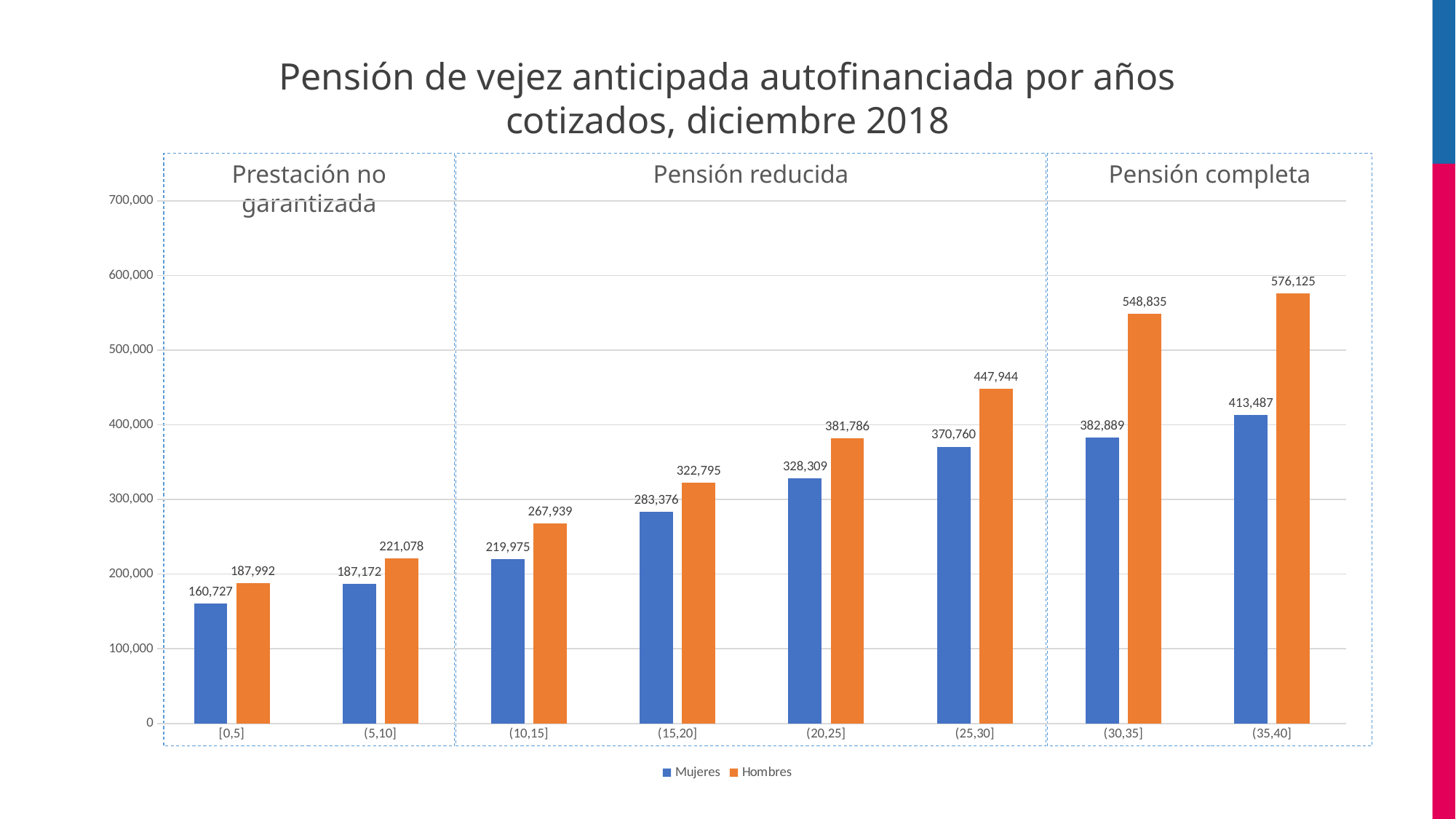
Is the value for Hombres in the (30,35] category greater or less than 500,000? greater Which category has the lowest value for Mujeres? [0,5] What is the difference between the Hombres and Mujeres values in the (35,40] category? 162,638 Which is larger: the Mujeres value for (35,40] or the Hombres value for (20,25]? Mujeres value for (35,40] What is the difference between the Hombres and Mujeres values in the (30,35] category? 165,946 What is the value for Hombres in the (25,30] category? 447,944 What is the value for Mujeres in the (15,20] category? 283,376 How many categories of years contributed are shown on the x axis? 8 What is the value for Mujeres in the [0,5] category? 160,727 Do the Hombres values rise or fall as the years contributed increase along the x axis? rise How many series does the legend list? 2 Which category has the highest value for Hombres? (35,40]